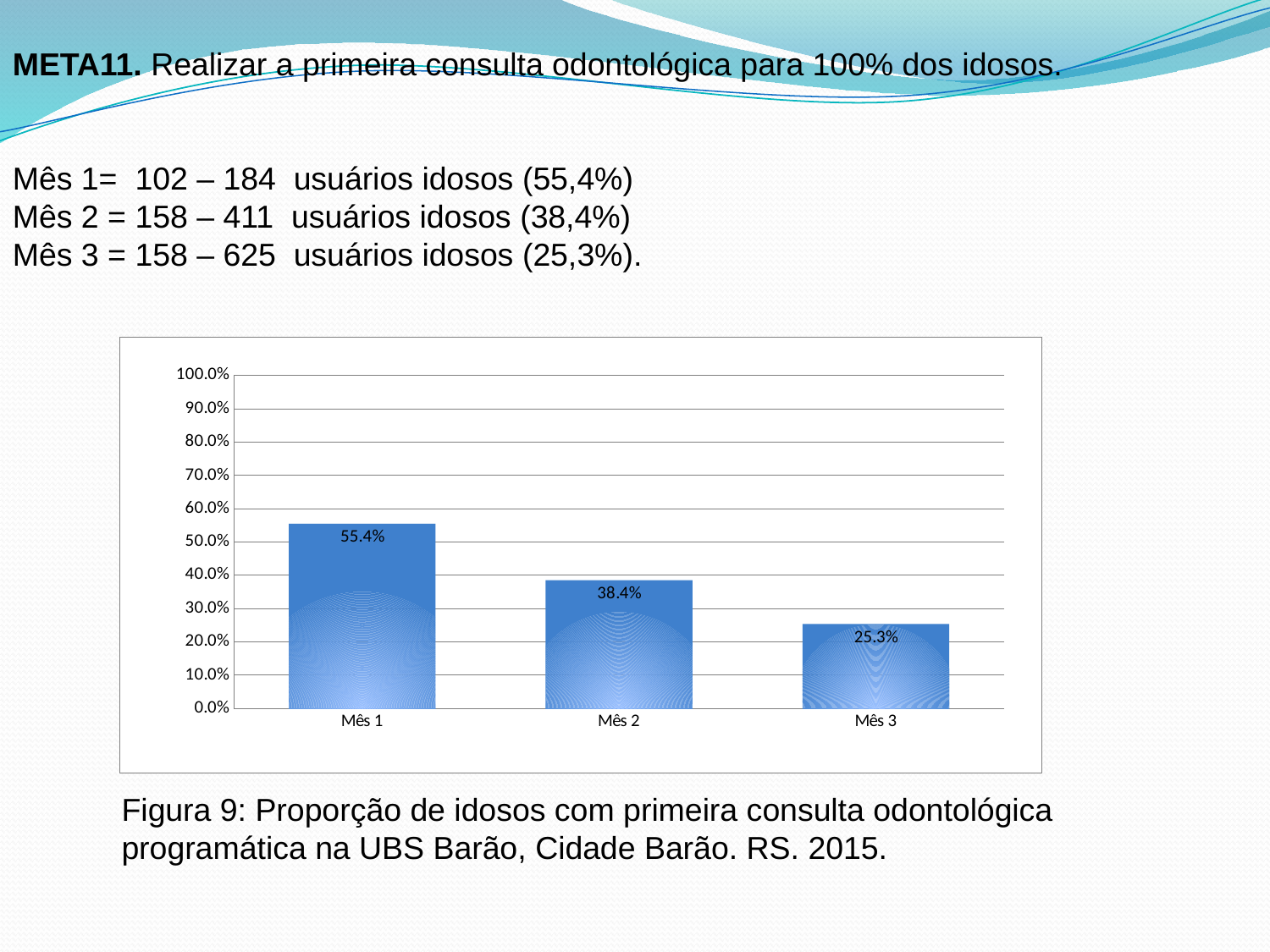
What is the value for Mês 1? 55.4% What is the value for Mês 3? 25.3% How many months are shown on the x axis? 3 What is the value for Mês 2? 38.4% Which is larger, the value for Mês 2 or the value for Mês 3? Mês 2 Which month has the highest value? Mês 1 Which month has the lowest value? Mês 3 What kind of chart is shown? bar chart Is the value for Mês 2 greater or less than 50.0%? less What is the difference between the values for Mês 1 and Mês 3? 30.1% Do the values rise or fall from Mês 1 to Mês 3? fall What is the difference between the values for Mês 1 and Mês 2? 17.0%